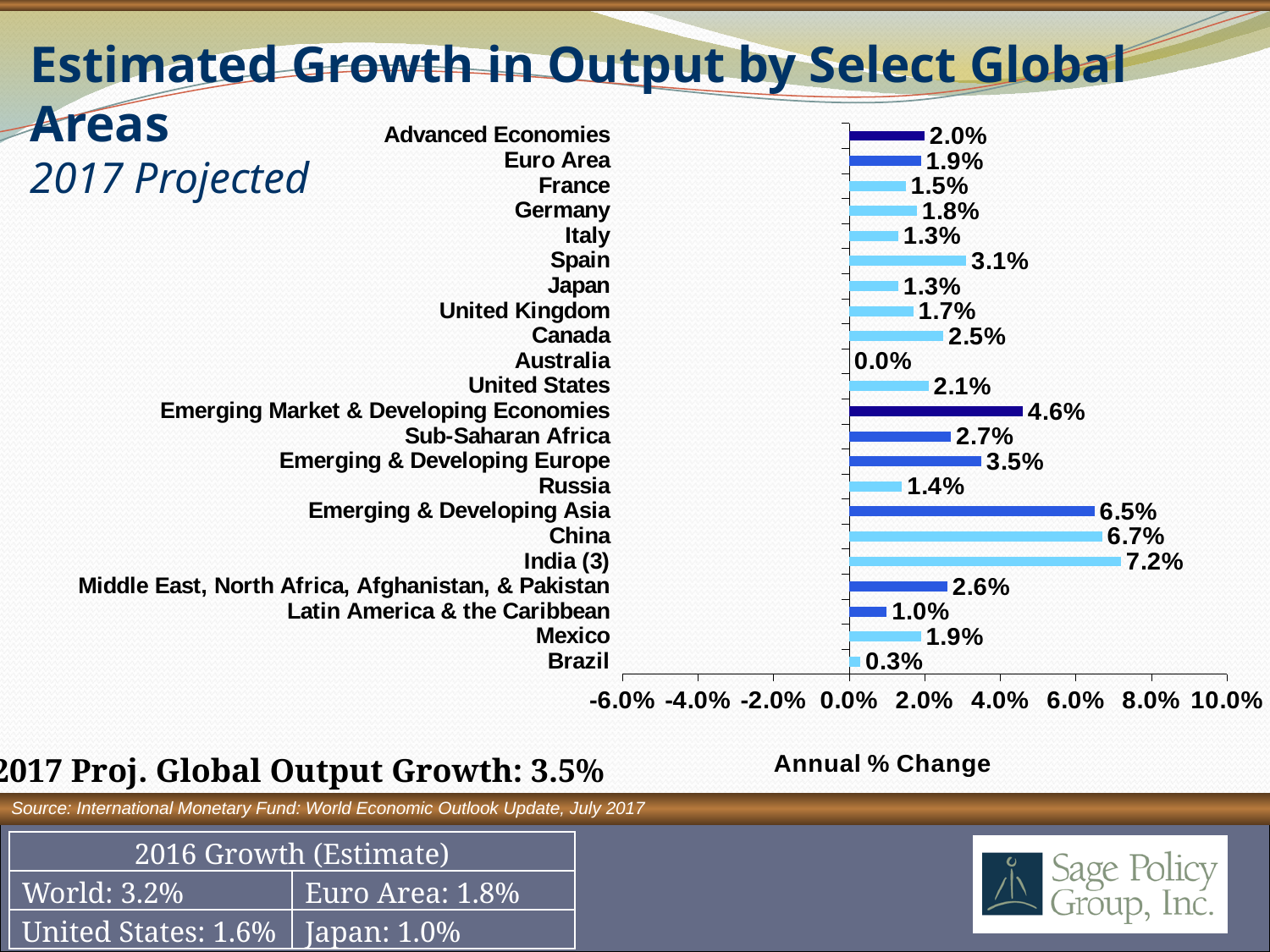
What is the projected 2017 growth in output for Spain? 3.1% Which area has the lowest projected 2017 growth in output? Australia What is the label of the horizontal axis of the chart? Annual % Change What is the projected 2017 growth in output for Emerging Market & Developing Economies? 4.6% What is the difference between the projected growth for Emerging & Developing Asia and Advanced Economies? 4.5% How many areas are plotted in the chart? 22 Which has a higher projected 2017 growth, Canada or the United States? Canada What is the projected 2017 growth in output for China? 6.7% What is the difference between the projected growth for India (3) and China? 0.5% What is the projected 2017 growth in output for Brazil? 0.3% What type of chart is shown on the slide? Bar chart Which area has the highest projected 2017 growth in output? India (3)